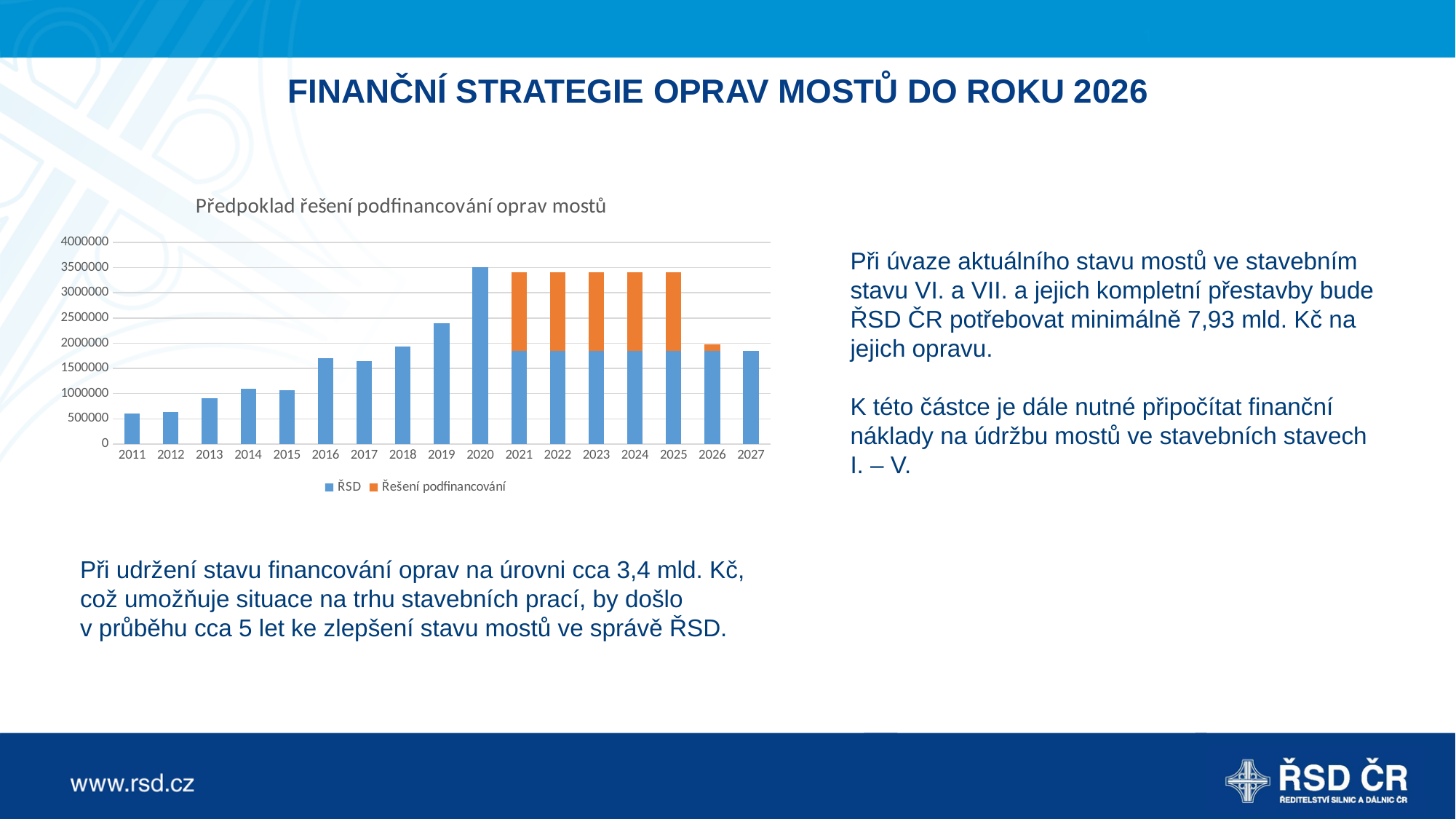
Is the value for 2013 greater or less than 1000000? less What is the title of the chart? Předpoklad řešení podfinancování oprav mostů Do the bar values generally rise or fall from 2011 to 2020? rise Is the value for 2016 greater or less than 1500000? greater Which year has the highest total bar in the chart? 2020 How many series does the chart legend list? 2 Which series is shown in orange? Řešení podfinancování Is the total bar for 2020 greater or less than 3000000? greater Which year has the larger bar, 2018 or 2019? 2019 How many years are shown on the x axis of the chart? 17 What kind of chart is shown on the slide? Stacked bar chart